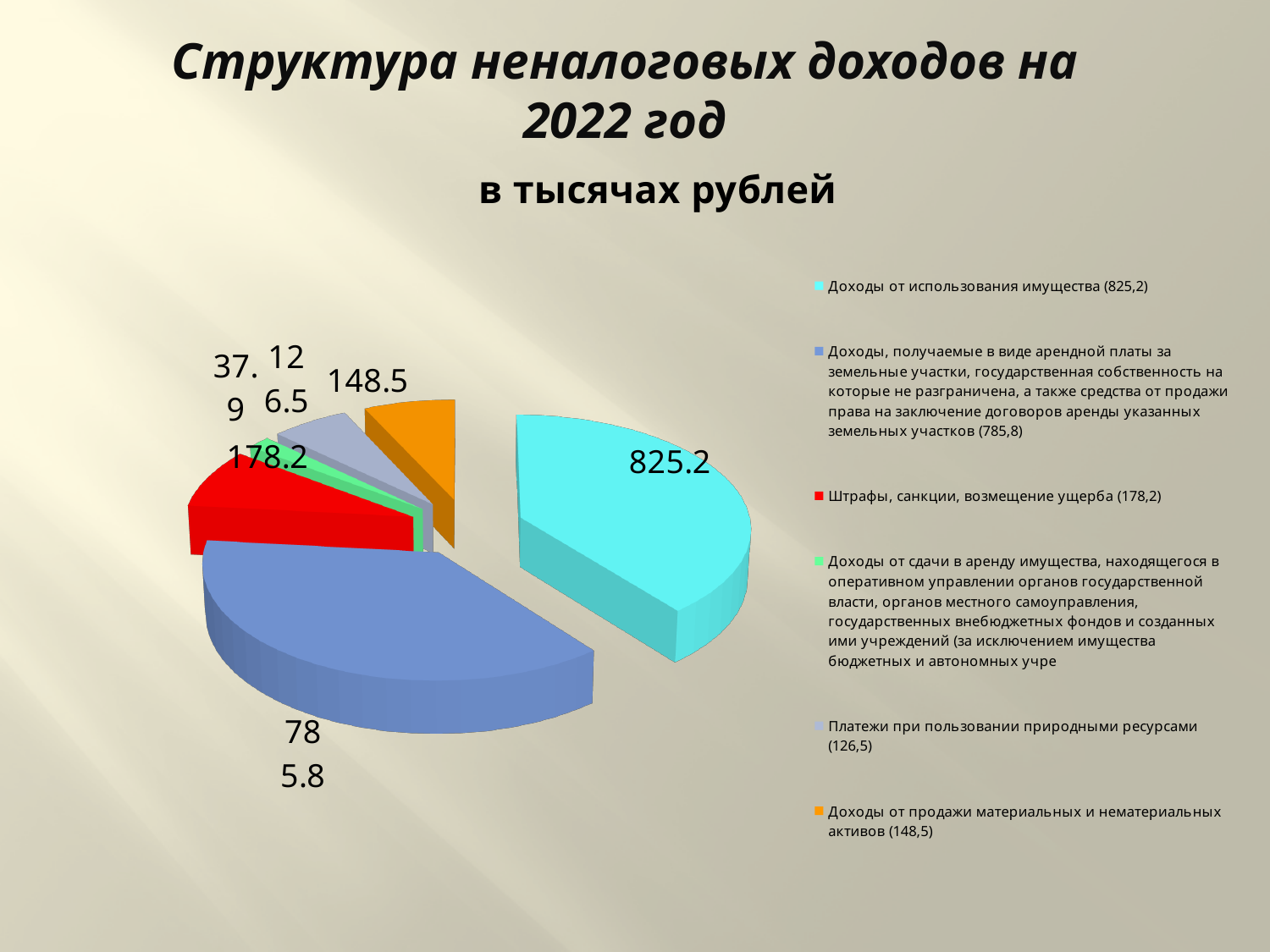
What is the value for Доходы от использования имущества? 825.2 What kind of chart is shown on the slide? pie chart How many slices does the pie chart have? 6 What is the difference between the value for Доходы от использования имущества (825.2) and the value for Штрафы, санкции, возмещение ущерба (178.2)? 647 Which category has the largest slice of the pie? Доходы от использования имущества What is the value for Доходы от продажи материальных и нематериальных активов? 148.5 What is the value for Штрафы, санкции, возмещение ущерба? 178.2 How many entries does the legend list? 6 What is the value for Платежи при пользовании природными ресурсами? 126.5 What is the value of the smallest slice of the pie? 37.9 What is the title of the chart on the slide? в тысячах рублей Which is larger: the value for Доходы от продажи материальных и нематериальных активов or the value for Платежи при пользовании природными ресурсами? Доходы от продажи материальных и нематериальных активов